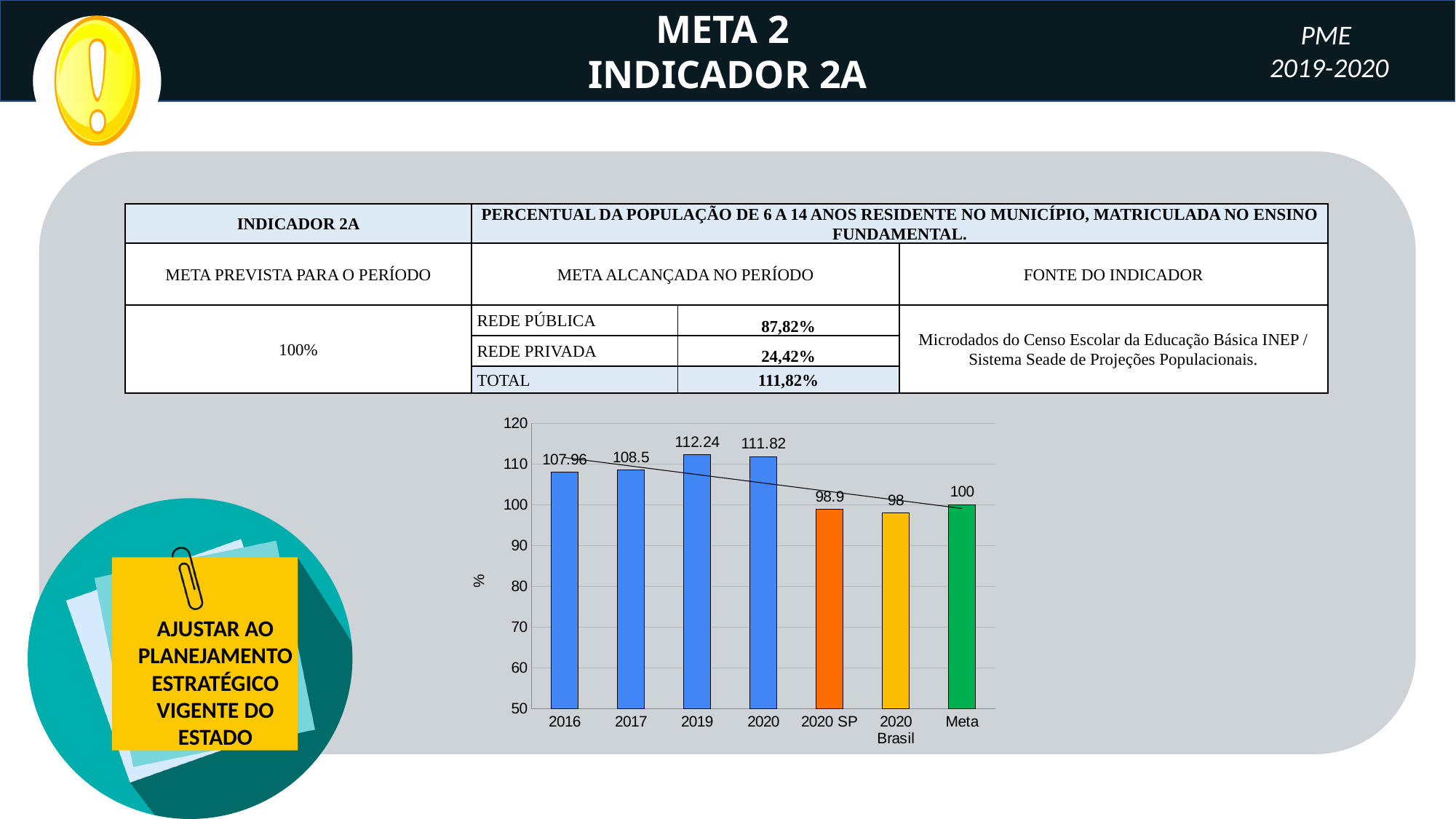
What is the value for Meta in the bar chart? 100 What is the value for 2019 in the bar chart? 112.24 Is the value for 2020 Brasil greater or less than 100 in the bar chart? less Which category has the highest value in the bar chart? 2019 What kind of chart is shown on the slide? bar chart How many bars are shown in the bar chart? 7 Which is larger in the bar chart, the value for 2020 or the value for 2020 SP? 2020 What is the value for 2020 SP in the bar chart? 98.9 Which category has the lowest value in the bar chart? 2020 Brasil What is the value for 2016 in the bar chart? 107.96 What is the difference between the values for 2019 and 2020 in the bar chart? 0.42 What is the label on the vertical axis of the bar chart? %